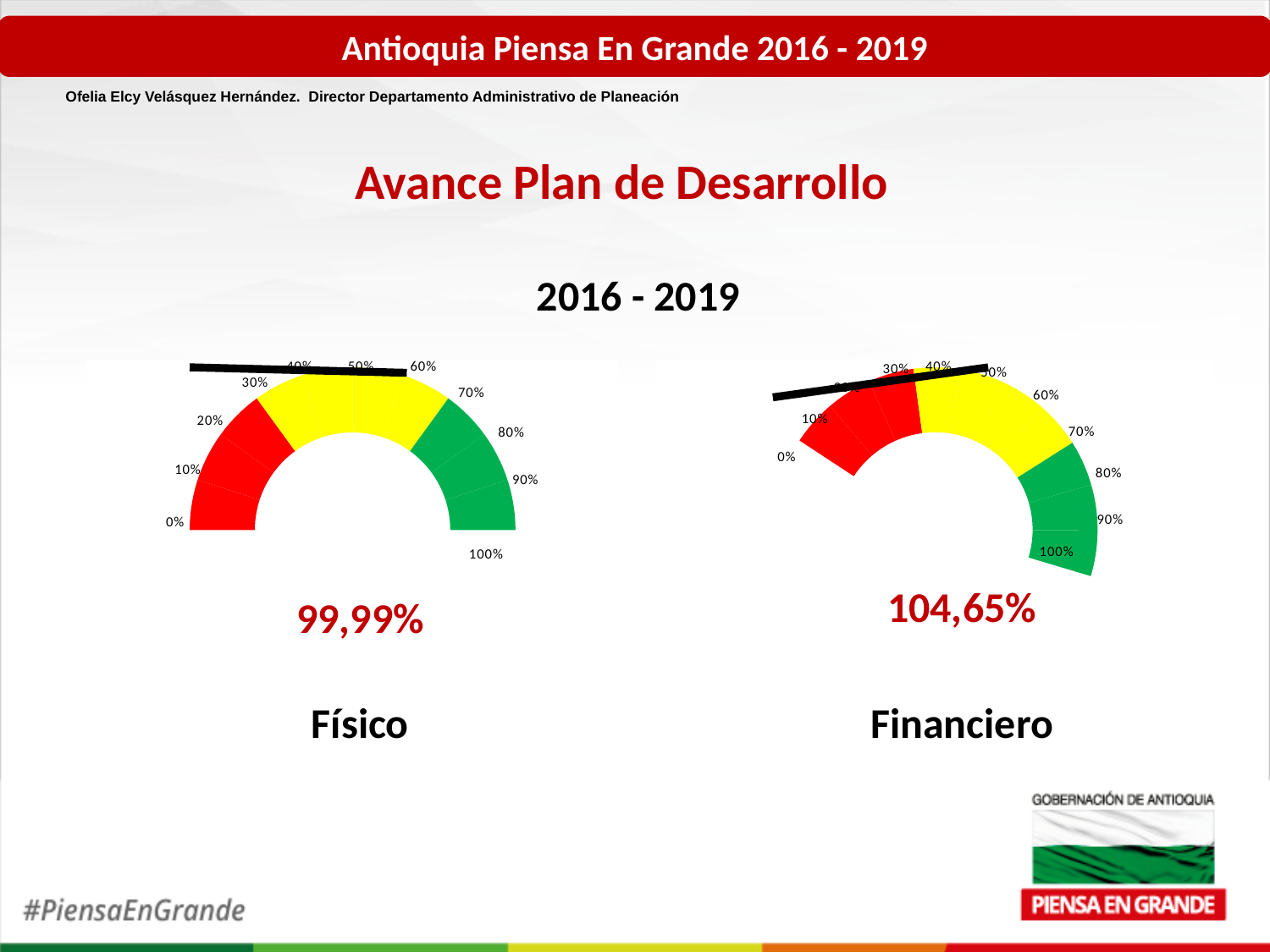
What is the highest tick label shown on the Físico gauge scale? 100% How many gauge charts are shown on the slide? 2 What value is shown for the Físico gauge chart? 99,99% What period do the gauge charts cover, according to the subtitle above them? 2016 - 2019 Which of the two gauges, Físico or Financiero, shows the lower value? Físico What value is shown for the Financiero gauge chart? 104,65% What three colours are used for the segments of the gauges? Red, yellow and green Is the value shown for the Físico gauge greater or less than 90%? greater What kind of chart is used to show the Físico and Financiero progress? Gauge chart Is the value shown for the Financiero gauge greater or less than 100%? greater What is the difference between the Financiero value and the Físico value? 4,66% Which of the two gauges, Físico or Financiero, shows the higher value? Financiero